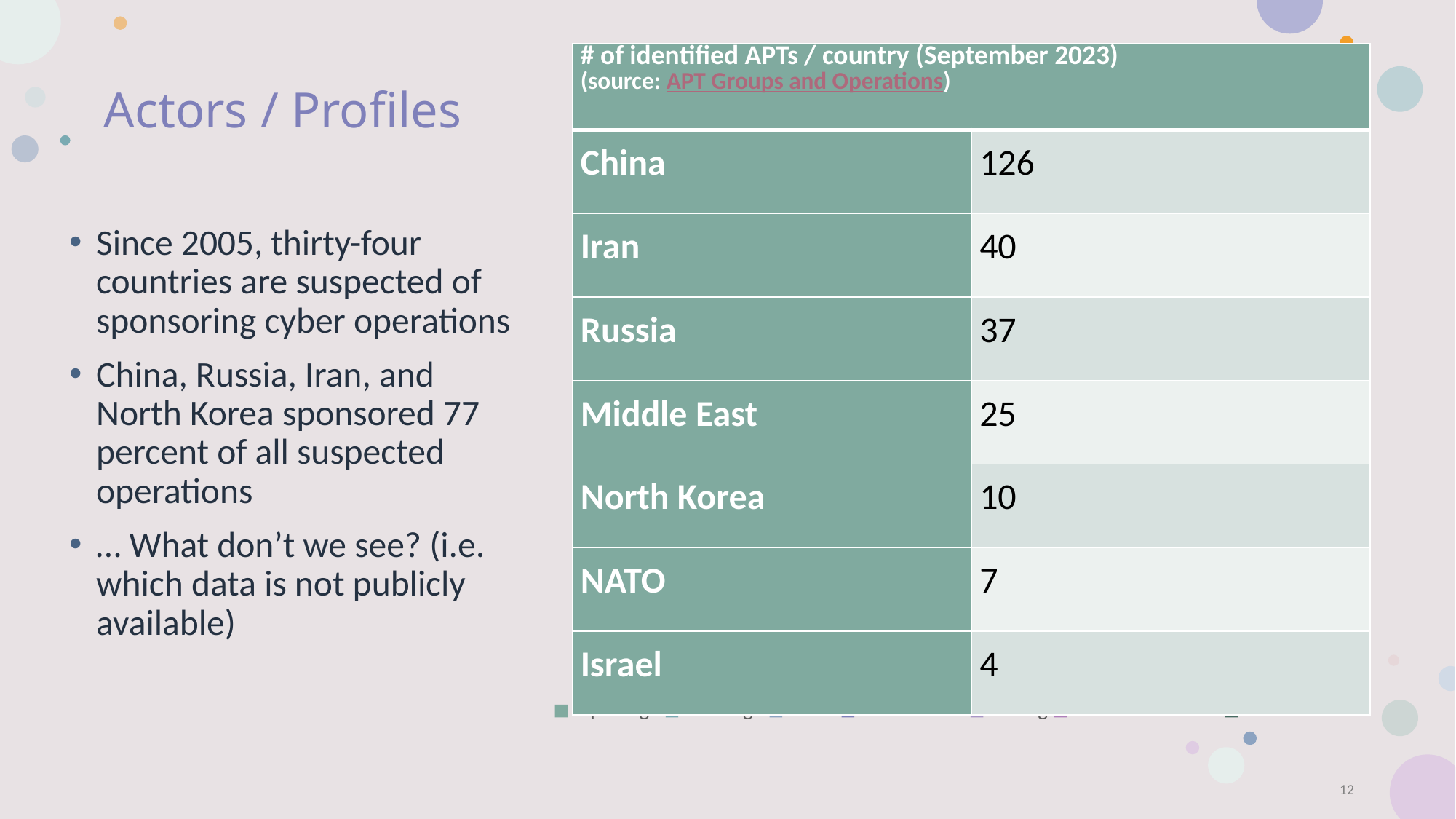
In the table '# of identified APTs / country (September 2023)', how many countries or regions are listed? 7 In the table '# of identified APTs / country (September 2023)', what is the value for NATO? 7 In the table '# of identified APTs / country (September 2023)', which entry has the lowest number of identified APTs? Israel In the table '# of identified APTs / country (September 2023)', what is the difference between the values for China and Iran? 86 In the table '# of identified APTs / country (September 2023)', how many identified APTs are listed for China? 126 In the table '# of identified APTs / country (September 2023)', how many identified APTs are listed for Iran? 40 In the table '# of identified APTs / country (September 2023)', what is the value for North Korea? 10 What source is cited in the header of the table '# of identified APTs / country (September 2023)'? APT Groups and Operations In the table '# of identified APTs / country (September 2023)', what is the value for Russia? 37 In the table '# of identified APTs / country (September 2023)', what is the difference between the values for Iran and Russia? 3 In the table '# of identified APTs / country (September 2023)', which country or region has the highest number of identified APTs? China In the table '# of identified APTs / country (September 2023)', which has more identified APTs, Middle East or NATO? Middle East